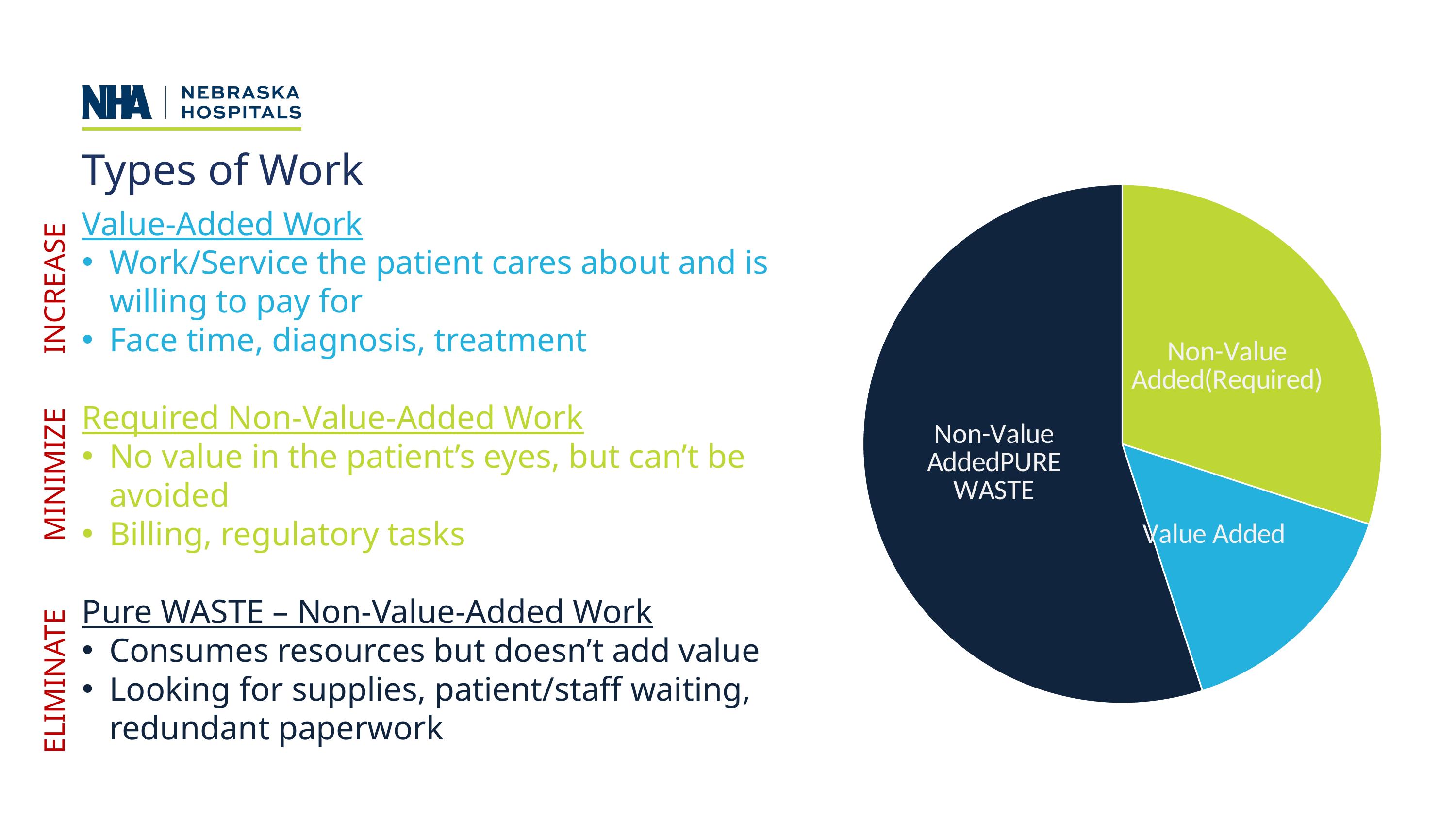
What colour is the Value Added slice in the pie chart? Blue Which slice of the pie chart is the largest? Non-Value Added PURE WASTE In the pie chart, which slice is larger: Non-Value Added PURE WASTE or Value Added? Non-Value Added PURE WASTE What kind of chart is shown on the right side of the slide? Pie chart In the pie chart, which slice is larger: Value Added or Non-Value Added (Required)? Non-Value Added (Required) Which slice of the pie chart is the smallest? Value Added What colour is the Non-Value Added (Required) slice in the pie chart? Green In the pie chart, which slice is larger: Non-Value Added PURE WASTE or Non-Value Added (Required)? Non-Value Added PURE WASTE How many slices does the pie chart have? 3